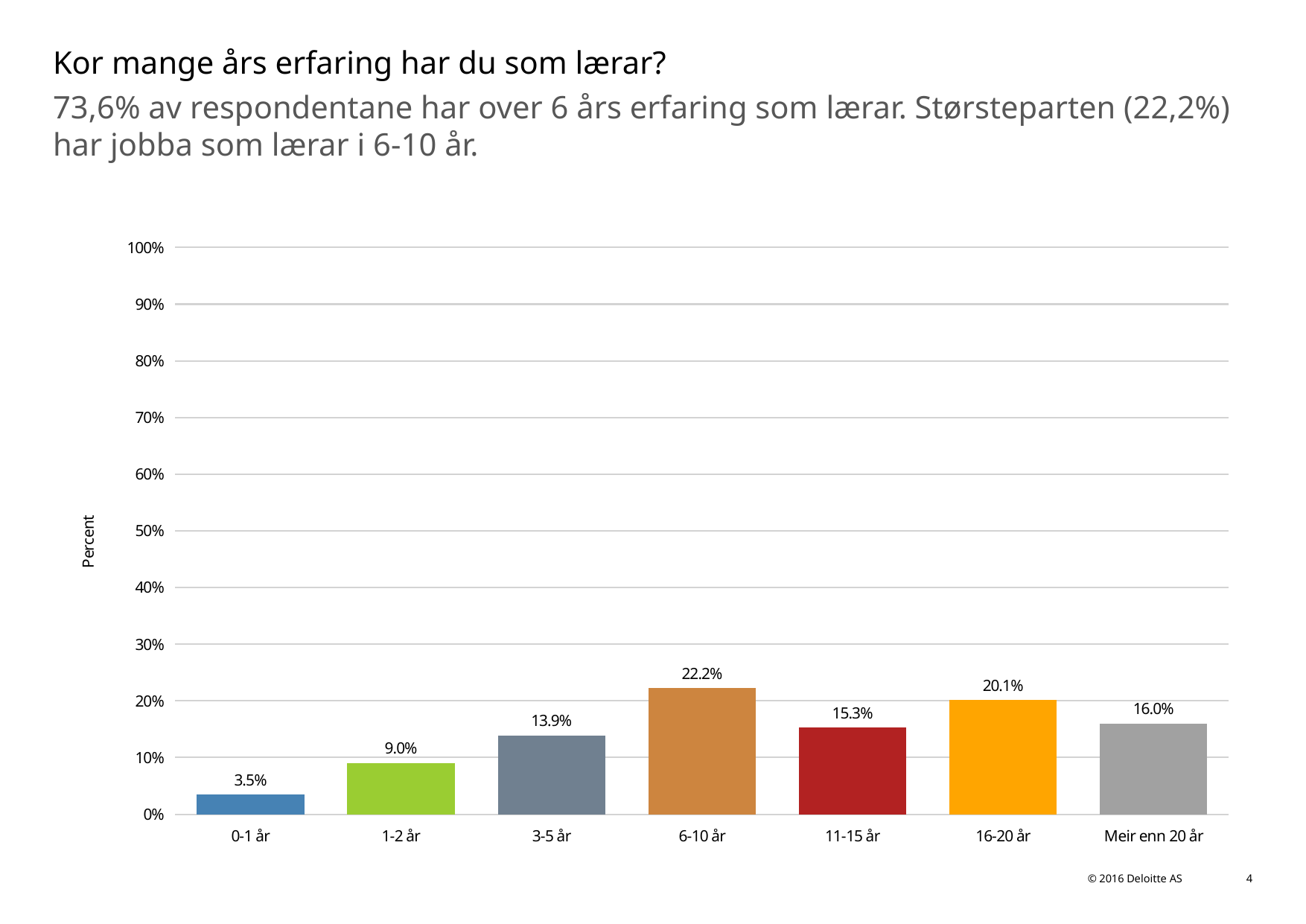
What kind of chart is shown on the slide? bar chart Which category has the highest value? 6-10 år Is the value for 3-5 år greater or less than 10%? greater What is the label of the y axis? Percent What is the value for the 0-1 år category? 3.5% What is the value for the 6-10 år category? 22.2% What is the value for the Meir enn 20 år category? 16.0% How many categories are shown on the x axis? 7 What is the difference between the values for 6-10 år and 16-20 år? 2.1% Which category has the lowest value? 0-1 år What is the difference between the values for 1-2 år and 3-5 år? 4.9% Which is larger, the value for 11-15 år or the value for Meir enn 20 år? Meir enn 20 år